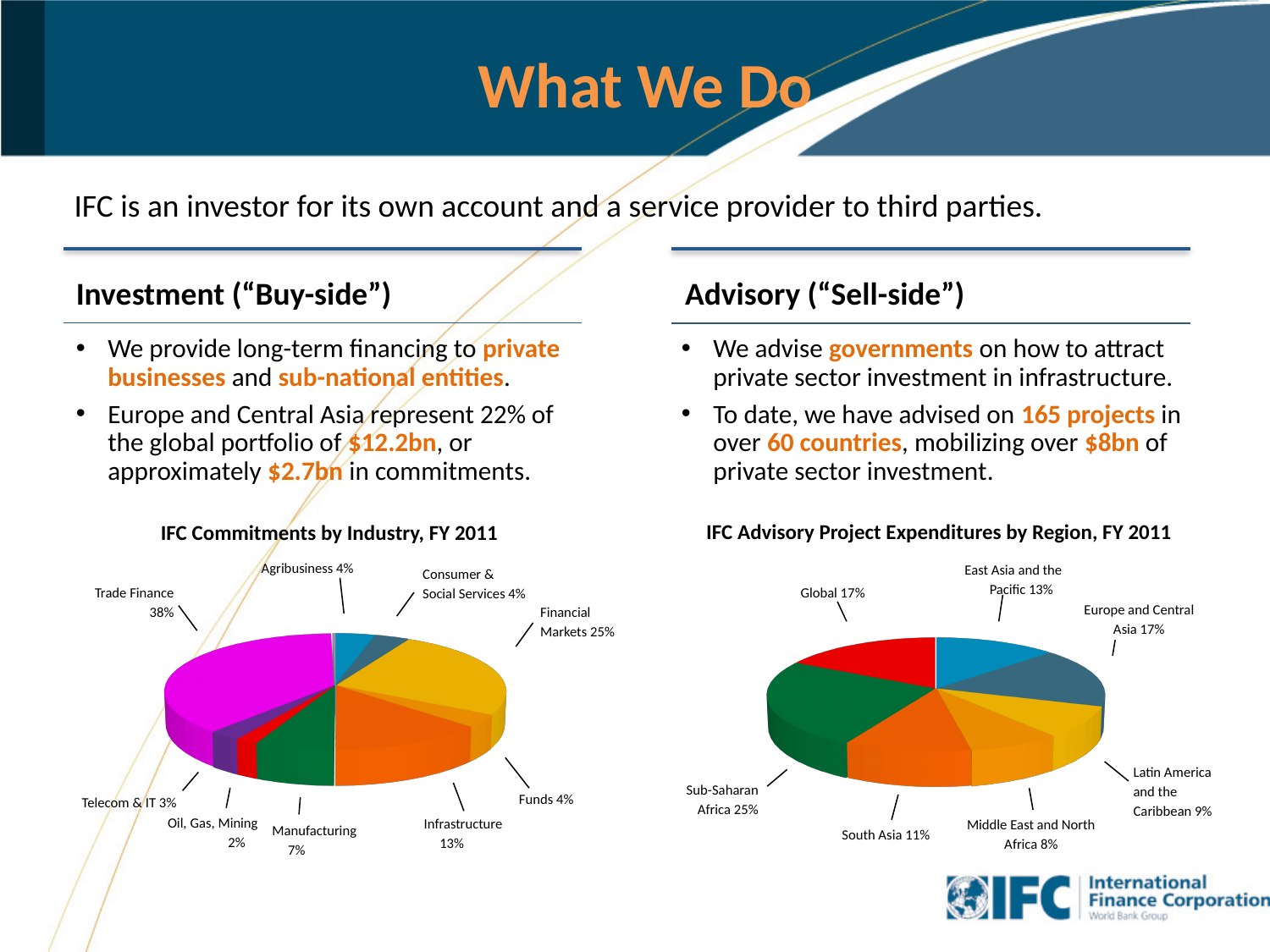
In the 'IFC Commitments by Industry, FY 2011' chart, which industry has the largest share? Trade Finance In the 'IFC Advisory Project Expenditures by Region, FY 2011' chart, which region has the smallest share? Middle East and North Africa In the 'IFC Commitments by Industry, FY 2011' chart, which industry has the smallest share? Oil, Gas, Mining What is the title of the chart on the left side of the slide? IFC Commitments by Industry, FY 2011 In the 'IFC Commitments by Industry, FY 2011' chart, how many industries are shown? 9 In the 'IFC Commitments by Industry, FY 2011' chart, what share does Infrastructure have? 13% In the 'IFC Advisory Project Expenditures by Region, FY 2011' chart, which is larger: South Asia or Latin America and the Caribbean? South Asia In the 'IFC Commitments by Industry, FY 2011' chart, what is the difference between the Financial Markets share and the Manufacturing share? 18% In the 'IFC Advisory Project Expenditures by Region, FY 2011' chart, how many regions are shown? 7 In the 'IFC Advisory Project Expenditures by Region, FY 2011' chart, what share does Sub-Saharan Africa have? 25% What kind of chart is 'IFC Advisory Project Expenditures by Region, FY 2011'? Pie chart In the 'IFC Commitments by Industry, FY 2011' chart, what share does Trade Finance have? 38%